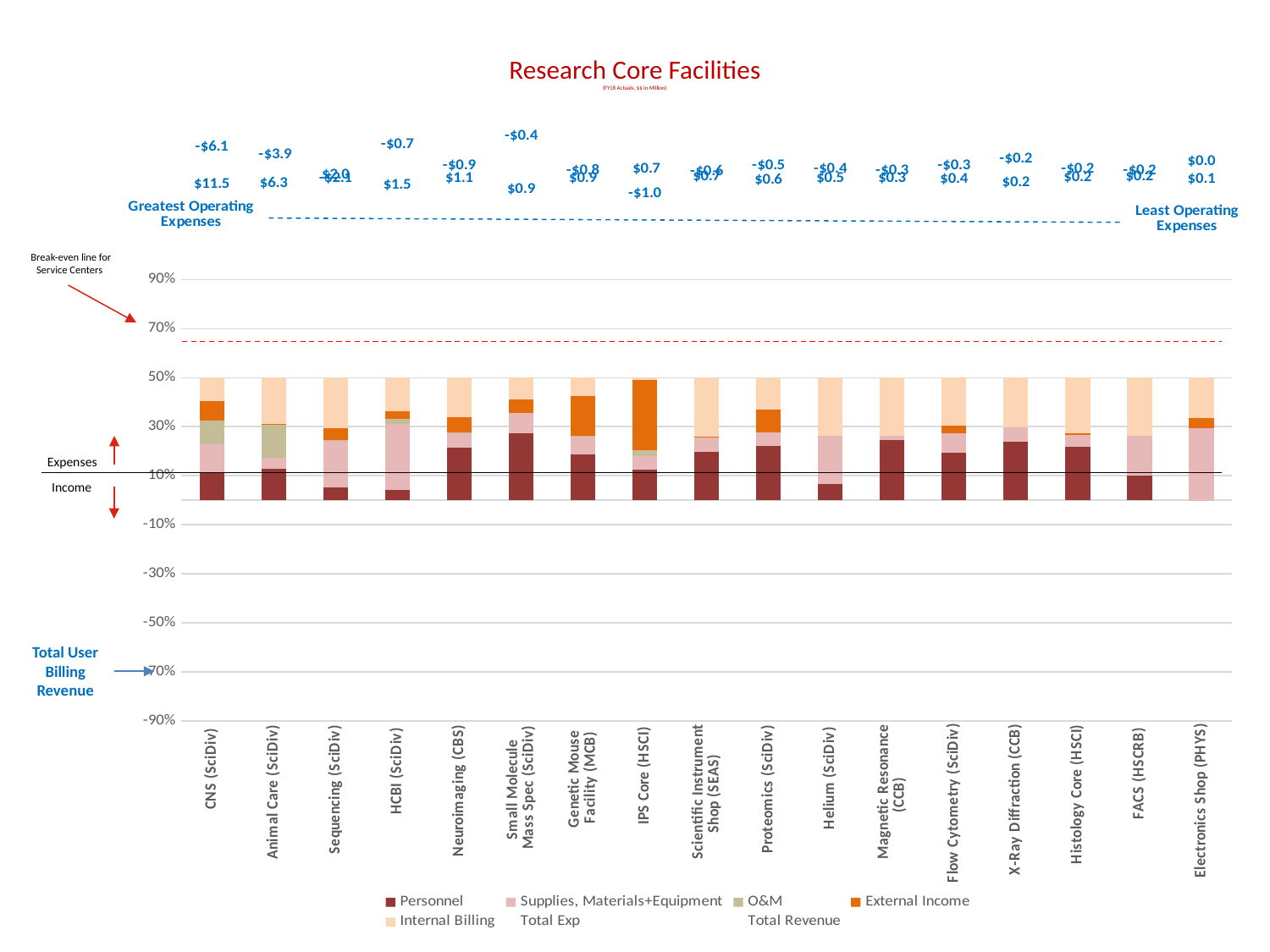
How many entries does the chart's legend list? 7 What negative dollar value is printed above the Animal Care (SciDiv) bar? -$3.9 What negative dollar value is printed above the IPS Core (HSCI) bar? -$1.0 What is the difference between the positive dollar values printed above CNS (SciDiv) and Animal Care (SciDiv)? $5.2 How many facilities (categories) are shown along the x axis of the chart? 17 Which is larger, the positive dollar value printed above CNS (SciDiv) or the one above Animal Care (SciDiv)? CNS (SciDiv) What positive dollar value is printed above the HCBI (SciDiv) bar? $1.5 What is the title of the chart? Research Core Facilities Which facility has the largest positive dollar value printed above its bar? CNS (SciDiv) Which facility is labelled at the far right of the x axis, under 'Least Operating Expenses'? Electronics Shop (PHYS) What kind of chart is shown on the slide? Stacked bar chart What positive dollar value is printed above the CNS (SciDiv) bar? $11.5